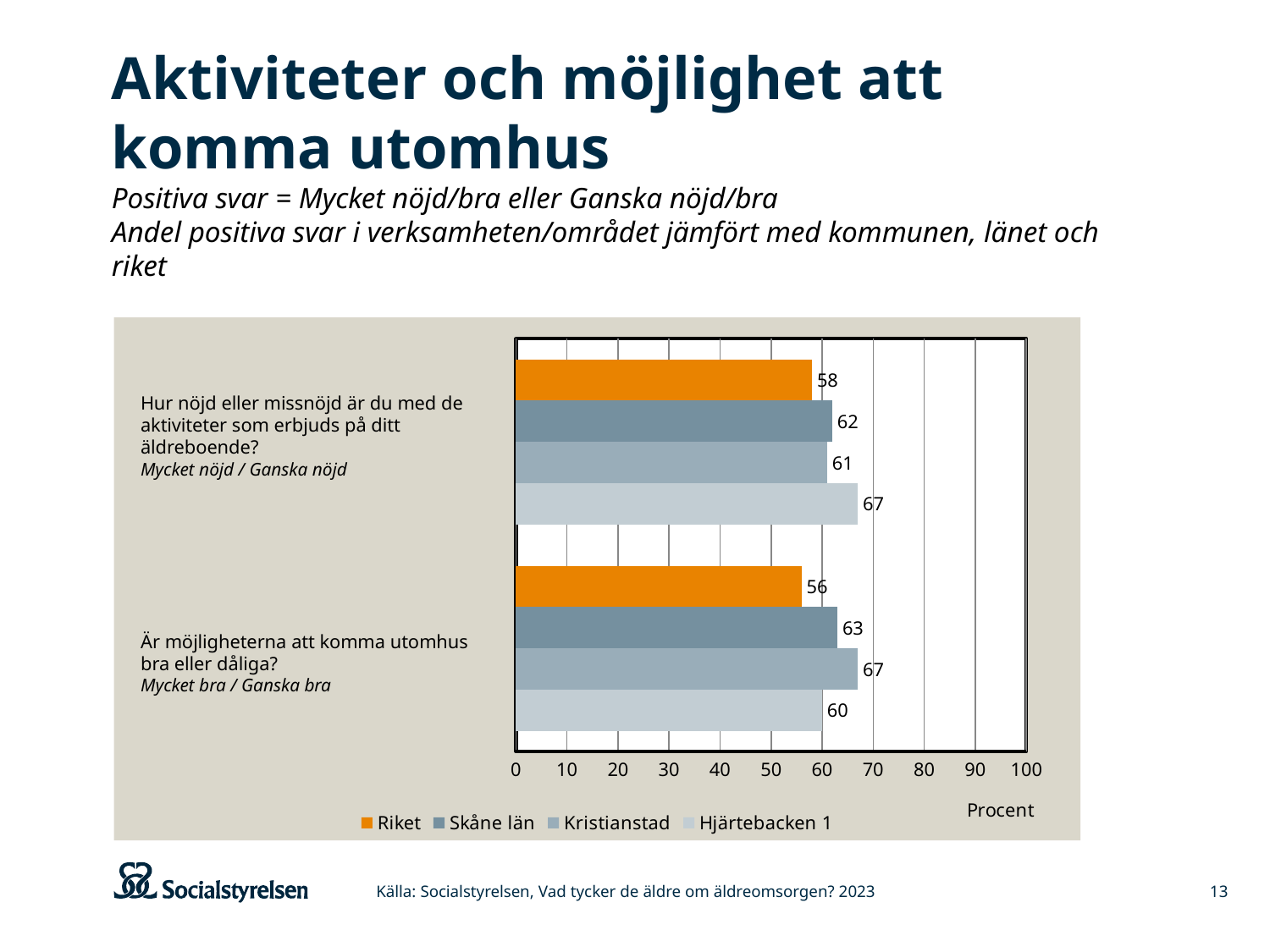
What is the value for Hjärtebacken 1 on the question about satisfaction with activities offered at the care home? 67 Which series has the highest value on the question about satisfaction with activities offered at the care home? Hjärtebacken 1 What is the value for Skåne län on the question about opportunities to get outdoors? 63 Which series has the lowest value on the question about opportunities to get outdoors? Riket What is the value for Kristianstad on the question about opportunities to get outdoors (Är möjligheterna att komma utomhus bra eller dåliga)? 67 What is the label of the x axis? Procent What kind of chart is shown on the slide? Bar chart How many series does the legend list? 4 Which is larger on the question about opportunities to get outdoors: Skåne län or Hjärtebacken 1? Skåne län What is the difference between Kristianstad and Hjärtebacken 1 on the question about opportunities to get outdoors? 7 What is the difference between Hjärtebacken 1 and Riket on the question about satisfaction with activities offered at the care home? 9 What is the value for Riket on the question about satisfaction with activities offered at the care home (Hur nöjd eller missnöjd är du med de aktiviteter som erbjuds på ditt äldreboende)? 58